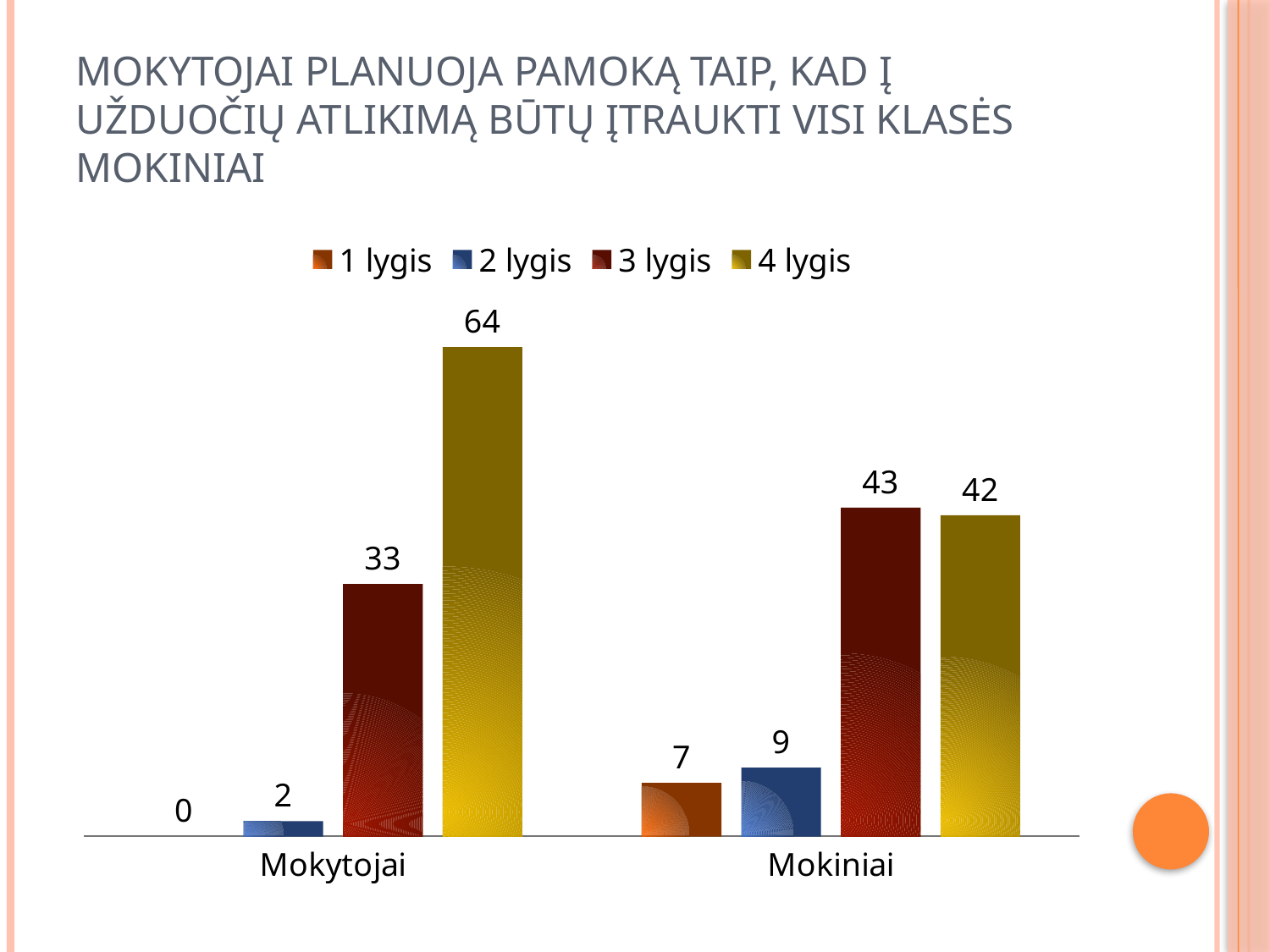
What is the value for 4 lygis in the Mokytojai category? 64 What is the value for 1 lygis in the Mokytojai category? 0 What is the value for 3 lygis in the Mokiniai category? 43 What is the difference between the 3 lygis and 2 lygis values in the Mokiniai category? 34 Which is larger: the 3 lygis value for Mokytojai or the 3 lygis value for Mokiniai? Mokiniai How many categories are shown on the x axis? 2 Which series has the lowest value in the Mokiniai category? 1 lygis What kind of chart is shown on the slide? Bar chart What is the value for 2 lygis in the Mokiniai category? 9 Which series has the highest value in the Mokytojai category? 4 lygis What is the difference between the 4 lygis values for Mokytojai and Mokiniai? 22 How many series does the legend list? 4